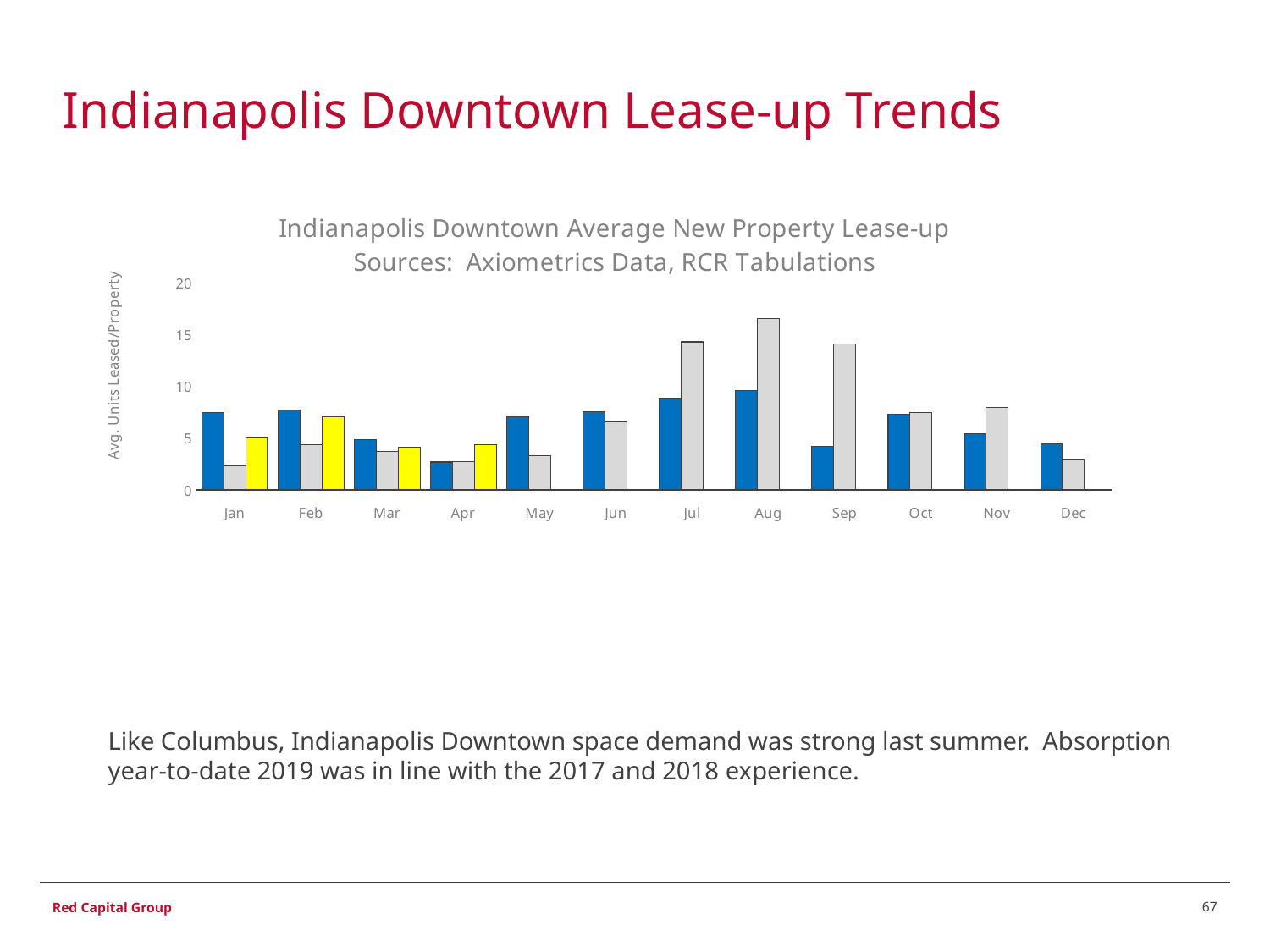
What kind of chart is shown on the slide? bar chart In which month is the gray bar the tallest? Aug Is the value of the blue bar for Aug greater or less than 10? less In Jul, which bar is taller, the blue bar or the gray bar? the gray bar Is the value of the gray bar for Aug greater or less than 15? greater In which month is the blue bar the tallest? Aug What is the label on the vertical axis of the chart? Avg. Units Leased/Property Is the value of the gray bar for Sep greater or less than 10? greater How many months are shown along the x axis of the chart? 12 In which month is the blue bar the shortest? Apr In Jan, which bar is taller, the blue bar or the yellow bar? the blue bar